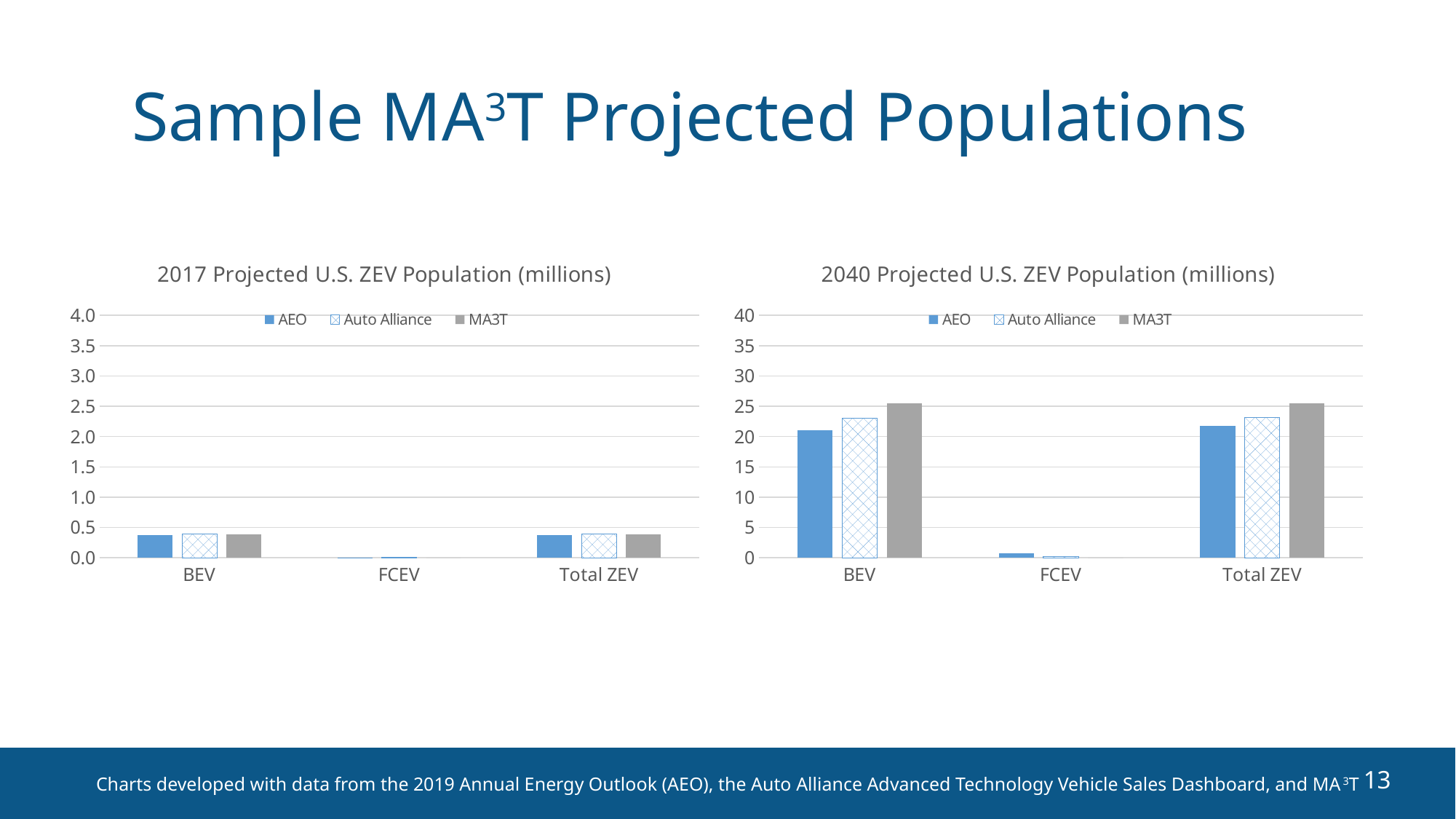
In the 2040 Projected U.S. ZEV Population chart, which is larger for Total ZEV: the AEO value or the MA3T value? MA3T In the 2040 Projected U.S. ZEV Population chart, is the AEO value for BEV greater or less than 20? greater How many categories are shown on the x axis of the 2040 Projected U.S. ZEV Population chart? 3 In the 2040 Projected U.S. ZEV Population chart, which category has the lowest values across all series? FCEV What is the title of the chart on the right side of the slide? 2040 Projected U.S. ZEV Population (millions) How many series does the legend of the 2017 Projected U.S. ZEV Population chart list? 3 What kind of chart is the 2017 Projected U.S. ZEV Population chart? bar chart Which series is shown with a cross-hatched pattern in the legend of the 2017 Projected U.S. ZEV Population chart? Auto Alliance In the 2040 Projected U.S. ZEV Population chart, which series has the highest value for BEV? MA3T In the 2040 Projected U.S. ZEV Population chart, is the MA3T value for BEV greater or less than 30? less In the 2017 Projected U.S. ZEV Population chart, which category has the lowest values? FCEV In the 2017 Projected U.S. ZEV Population chart, is the AEO value for BEV greater or less than 0.5? less